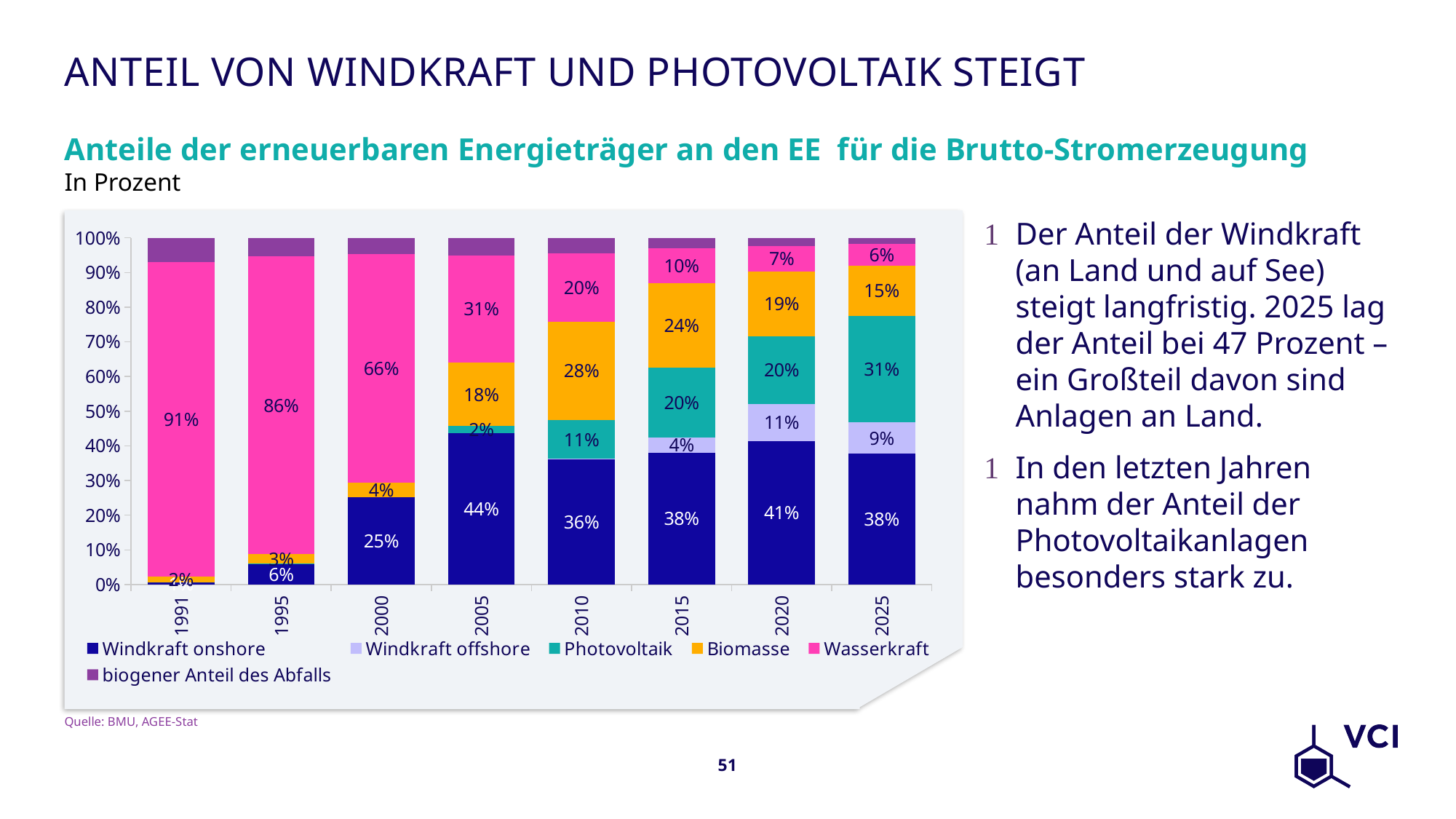
Does the share of Wasserkraft rise or fall from 1991 to 2025? It falls What is the share of Photovoltaik in 2025? 31% By how many percentage points did the share of Photovoltaik increase from 2015 to 2025? 11 percentage points What share does Biomasse have in 2010? 28% How many series does the legend list? 6 What is the share of Windkraft offshore in 2020? 11% What is the share of Windkraft onshore in 2005? 44% What share does Wasserkraft have in 1991? 91% In which year is the share of Windkraft onshore the highest? 2005 In which year is the labelled share of Wasserkraft the lowest? 2025 In 2015, which is larger: the share of Biomasse or the share of Wasserkraft? Biomasse How many years are shown on the x axis? 8